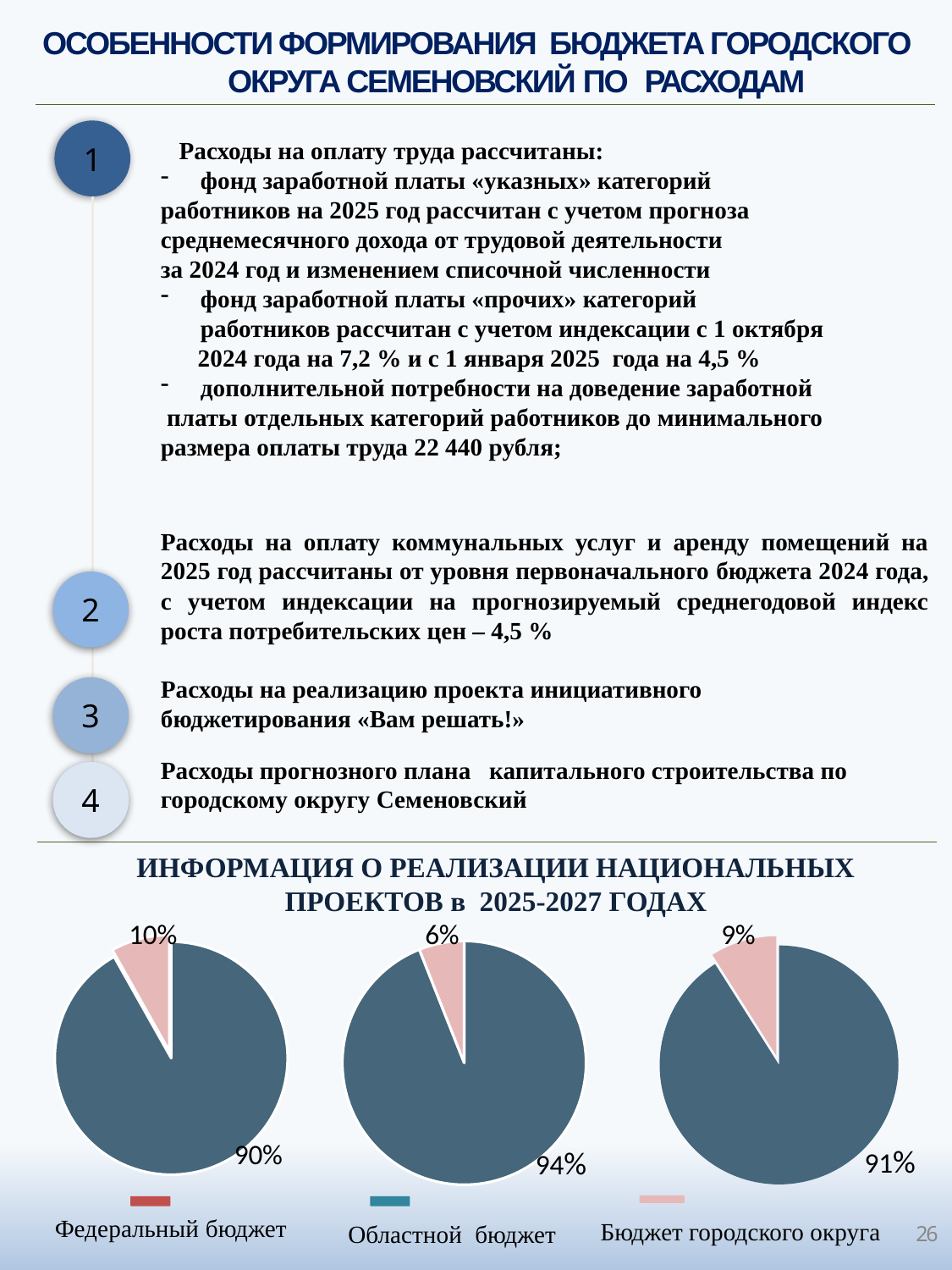
Which of the three pie charts has the smallest value for its pink slice? The middle pie chart (6%) In the middle pie chart, what percentage is shown for the larger slice? 94% In the right pie chart, what percentage is shown for the small pink slice? 9% In the left pie chart, what percentage is shown for the small pink slice? 10% Is the pink slice larger in the left pie chart or in the right pie chart? The left pie chart (10%) How many entries does the legend below the pie charts list? 3 In the middle pie chart, what percentage is shown for the small pink slice? 6% In the left pie chart, what percentage is shown for the larger slice? 90% In the right pie chart, what percentage is shown for the larger slice? 91% How many pie charts are shown on the slide? 3 In the left pie chart, what is the difference between the two slice values? 80 percentage points Which of the three pie charts has the largest value for its big slice? The middle pie chart (94%)